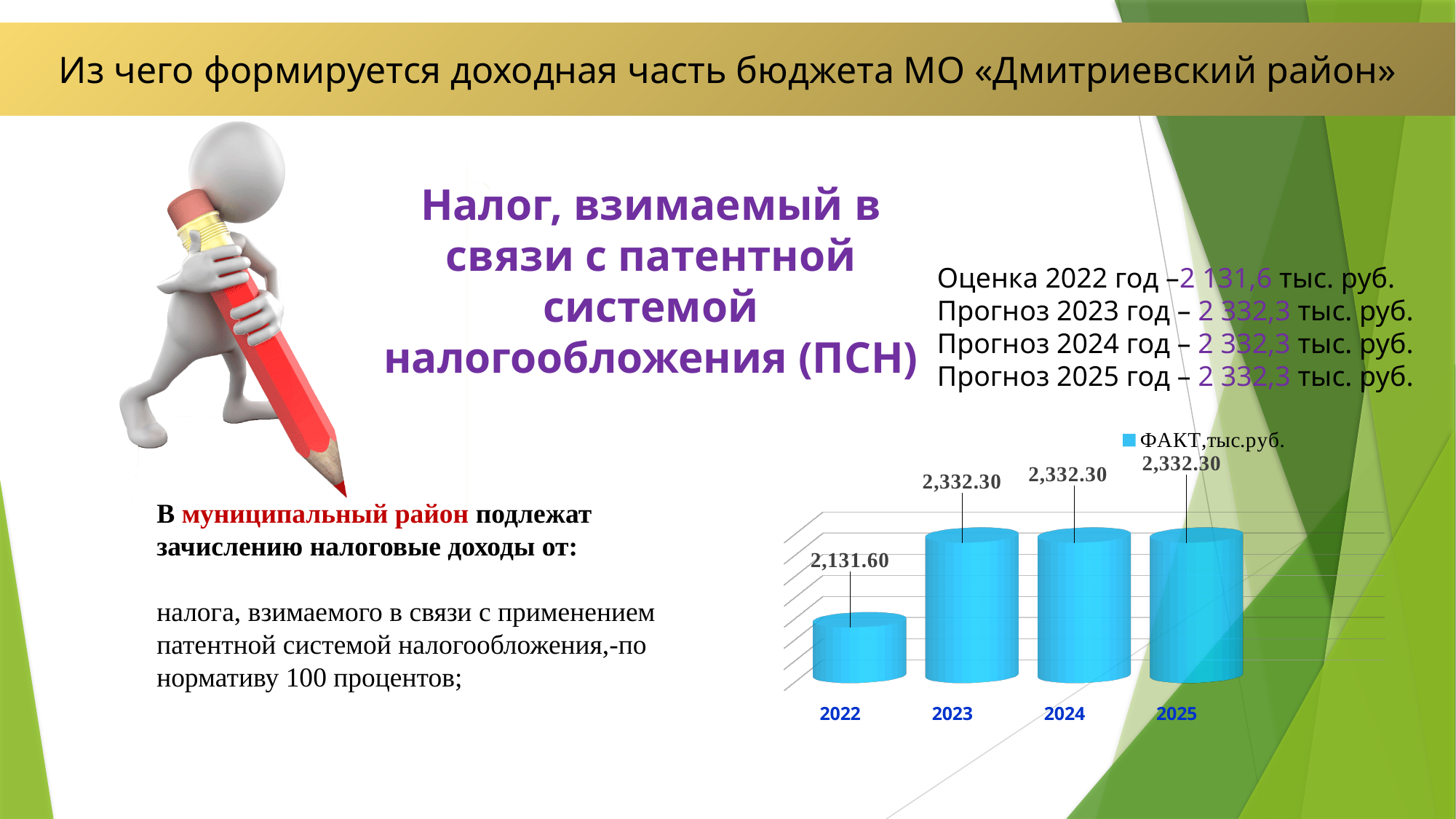
Which is larger, the value for 2022 or the value for 2024? 2024 How many series does the chart legend list? 1 What is the name of the series in the chart legend? ФАКТ,тыс.руб. What is the value for 2023 in the chart? 2,332.30 How many years are shown on the x axis of the chart? 4 What kind of chart is shown on the slide? bar chart What is the value for 2022 in the chart? 2,131.60 Which year has the lowest value in the chart? 2022 What colour are the bars in the chart? blue Does the value rise or fall from 2022 to 2023? rise What is the value for 2025 in the chart? 2,332.30 What is the difference between the values for 2023 and 2022? 200.70